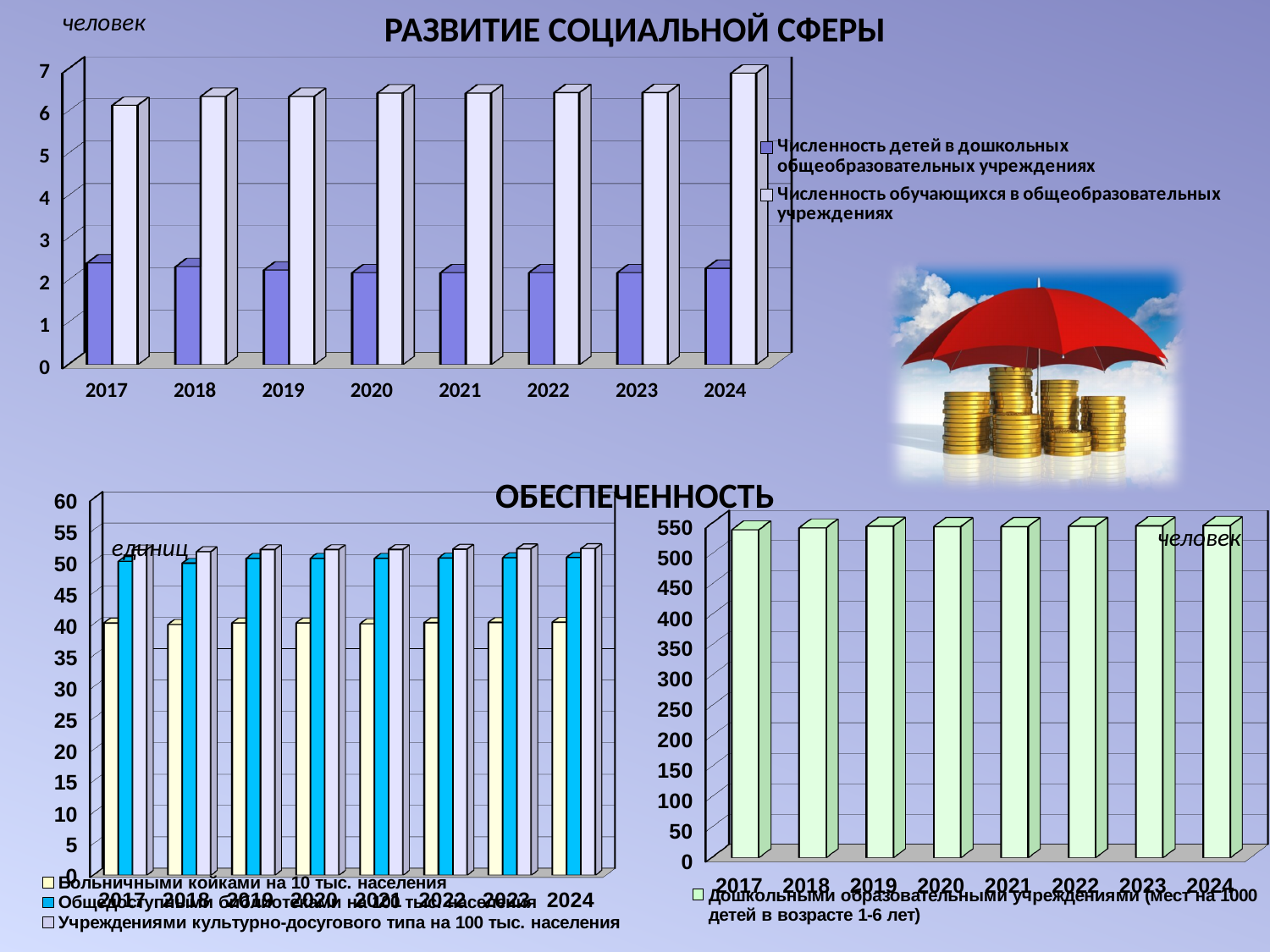
In the bottom-left chart under 'ОБЕСПЕЧЕННОСТЬ', which series has the larger value in 2020: 'Больничными койками на 10 тыс. населения' or 'Общедоступными библиотеками на 100 тыс. населения'? Общедоступными библиотеками на 100 тыс. населения In the bottom-right chart under 'ОБЕСПЕЧЕННОСТЬ', what unit label is shown on the chart? человек In the bottom-left chart under 'ОБЕСПЕЧЕННОСТЬ', is the value for 'Больничными койками на 10 тыс. населения' in 2017 greater or less than 45? less In the top chart titled 'РАЗВИТИЕ СОЦИАЛЬНОЙ СФЕРЫ', how many series does the legend list? 2 What kind of chart is the top chart titled 'РАЗВИТИЕ СОЦИАЛЬНОЙ СФЕРЫ'? bar chart In the top chart titled 'РАЗВИТИЕ СОЦИАЛЬНОЙ СФЕРЫ', how many years are shown on the x axis? 8 In the bottom-right chart under 'ОБЕСПЕЧЕННОСТЬ', is the value for 2017 greater or less than 500? greater In the top chart titled 'РАЗВИТИЕ СОЦИАЛЬНОЙ СФЕРЫ', is the value for 'Численность детей в дошкольных общеобразовательных учреждениях' in 2017 greater or less than 3? less In the top chart titled 'РАЗВИТИЕ СОЦИАЛЬНОЙ СФЕРЫ', which series has the larger value in 2020: 'Численность детей в дошкольных общеобразовательных учреждениях' or 'Численность обучающихся в общеобразовательных учреждениях'? Численность обучающихся в общеобразовательных учреждениях In the bottom-left chart under 'ОБЕСПЕЧЕННОСТЬ', how many series does the legend list? 3 In the top chart titled 'РАЗВИТИЕ СОЦИАЛЬНОЙ СФЕРЫ', in which year is the value for 'Численность обучающихся в общеобразовательных учреждениях' highest? 2024